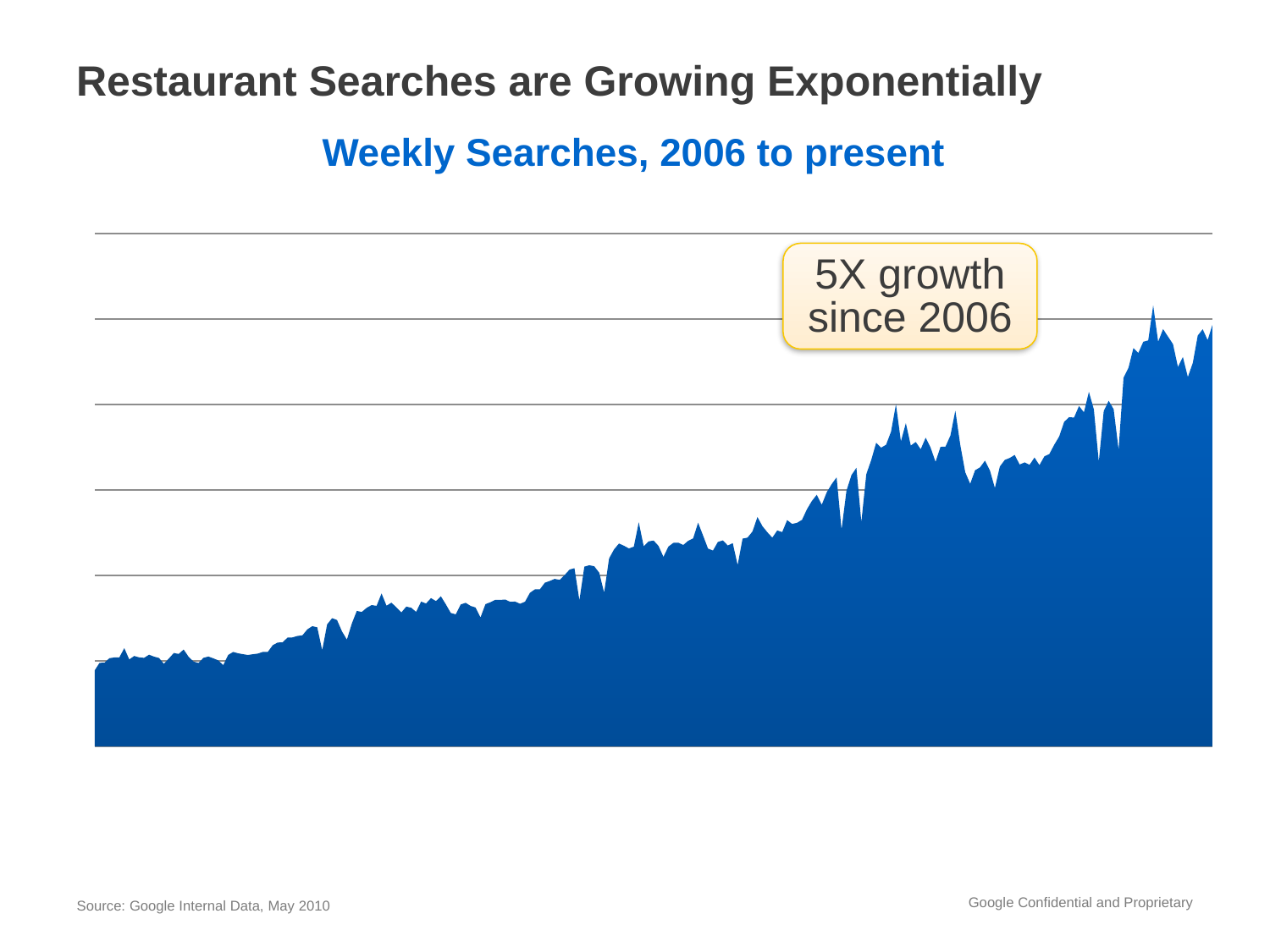
Do the weekly searches generally rise or fall from left to right across the chart? Rise What kind of chart is shown on the slide? Area chart What is the title of the chart? Weekly Searches, 2006 to present According to the callout on the chart, how much have searches grown since 2006? 5X growth